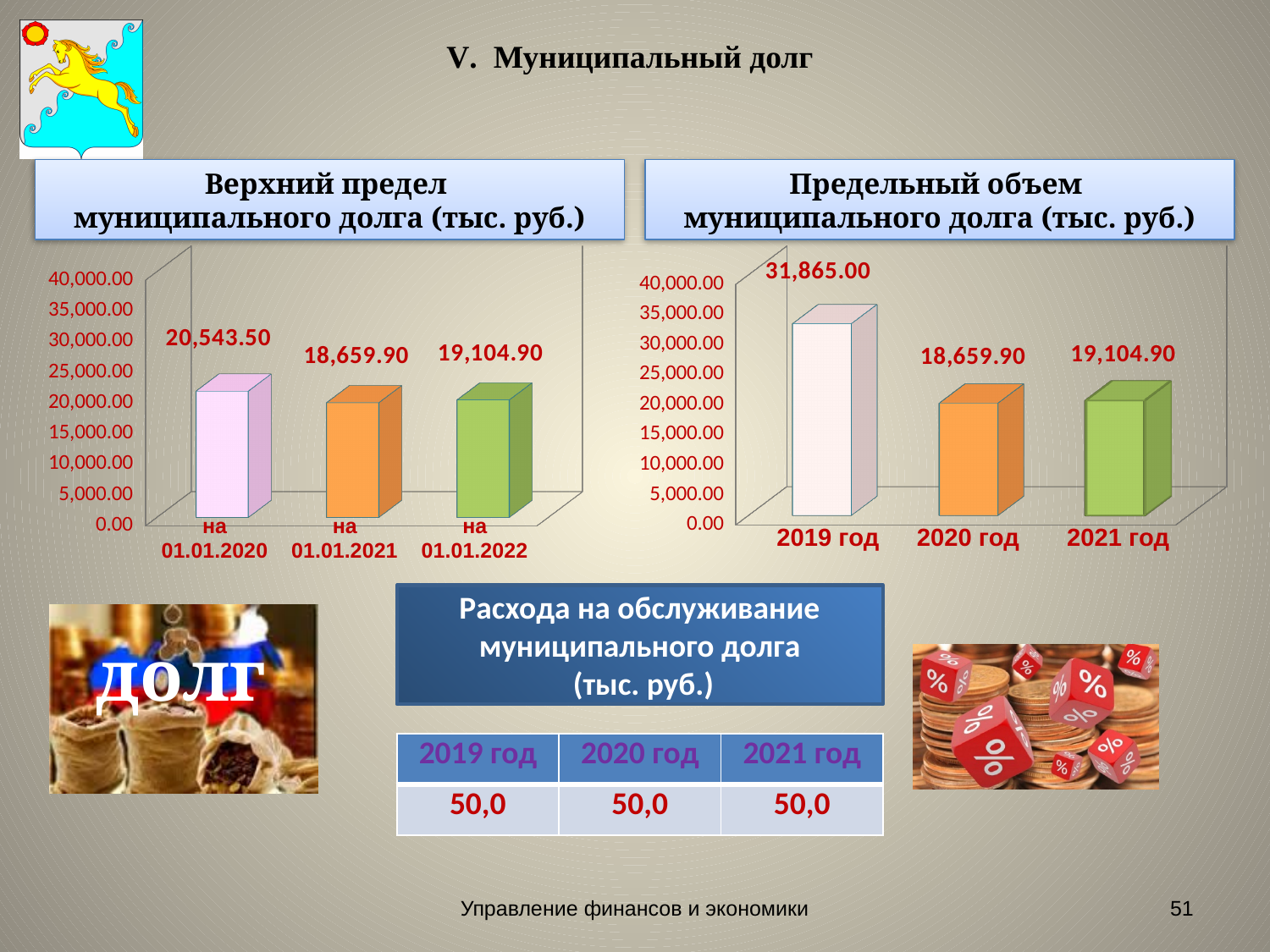
In the chart 'Верхний предел муниципального долга (тыс. руб.)', what is the difference between the values for на 01.01.2020 and на 01.01.2021? 1,883.60 In the chart 'Верхний предел муниципального долга (тыс. руб.)', how many bars are plotted? 3 In the chart 'Предельный объем муниципального долга (тыс. руб.)', which is larger: the value for 2020 год or 2021 год? 2021 год In the chart 'Предельный объем муниципального долга (тыс. руб.)', what is the value for 2020 год? 18,659.90 What type of chart is 'Верхний предел муниципального долга (тыс. руб.)'? bar chart In the chart 'Верхний предел муниципального долга (тыс. руб.)', what is the value for на 01.01.2022? 19,104.90 In the chart 'Предельный объем муниципального долга (тыс. руб.)', what is the value for 2019 год? 31,865.00 In the chart 'Верхний предел муниципального долга (тыс. руб.)', what is the value for на 01.01.2020? 20,543.50 In the chart 'Верхний предел муниципального долга (тыс. руб.)', which category has the lowest value? на 01.01.2021 In the chart 'Предельный объем муниципального долга (тыс. руб.)', what is the difference between the values for 2019 год and 2021 год? 12,760.10 In the chart 'Предельный объем муниципального долга (тыс. руб.)', is the value for 2019 год greater or less than 30,000.00? greater In the chart 'Предельный объем муниципального долга (тыс. руб.)', which year has the highest value? 2019 год